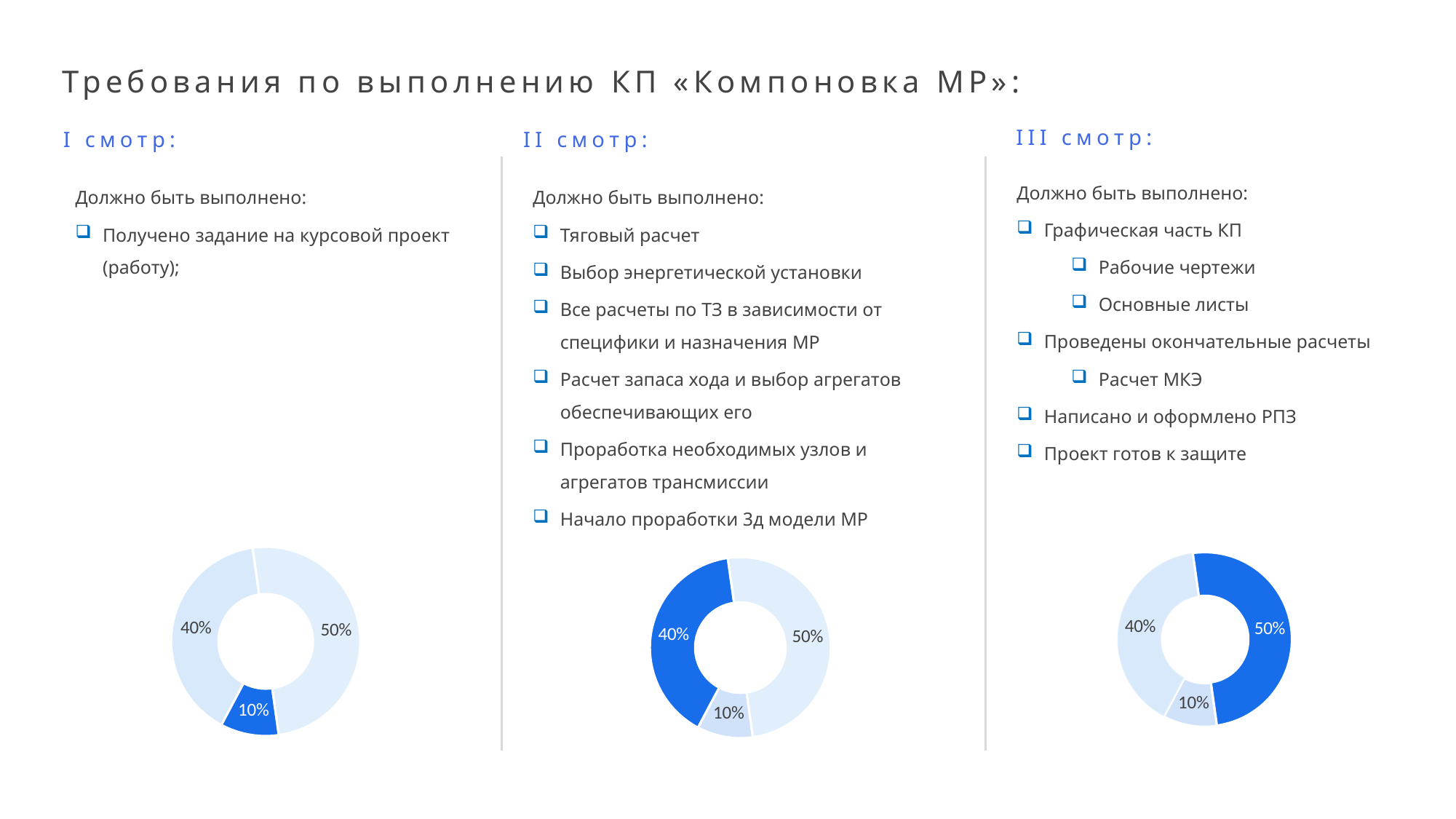
In the donut chart under "II смотр" in the middle, which slice is shown in dark blue? 40% In the donut chart under "I смотр" on the left, what is the largest slice's value? 50% In the donut chart under "II смотр" in the middle, what is the difference between the largest and smallest slices? 40% What are the three values labelled on the donut chart under "III смотр" on the right? 50%, 40%, 10% In the donut chart under "II смотр" in the middle, is the dark blue slice greater or less than 50%? less In the donut chart under "I смотр" on the left, which slice is shown in dark blue? 10% How many donut charts are on the slide? 3 What kind of chart is shown under "I смотр" on the left of the slide? Pie chart (donut) In the donut chart under "III смотр" on the right, which is larger, the dark blue slice or the 40% slice? The dark blue slice (50%) In the donut chart under "III смотр" on the right, what is the smallest slice's value? 10% In the donut chart under "I смотр" on the left, what is the combined share of the 40% and 10% slices? 50% How many slices does the donut chart under "II смотр" in the middle of the slide have? 3